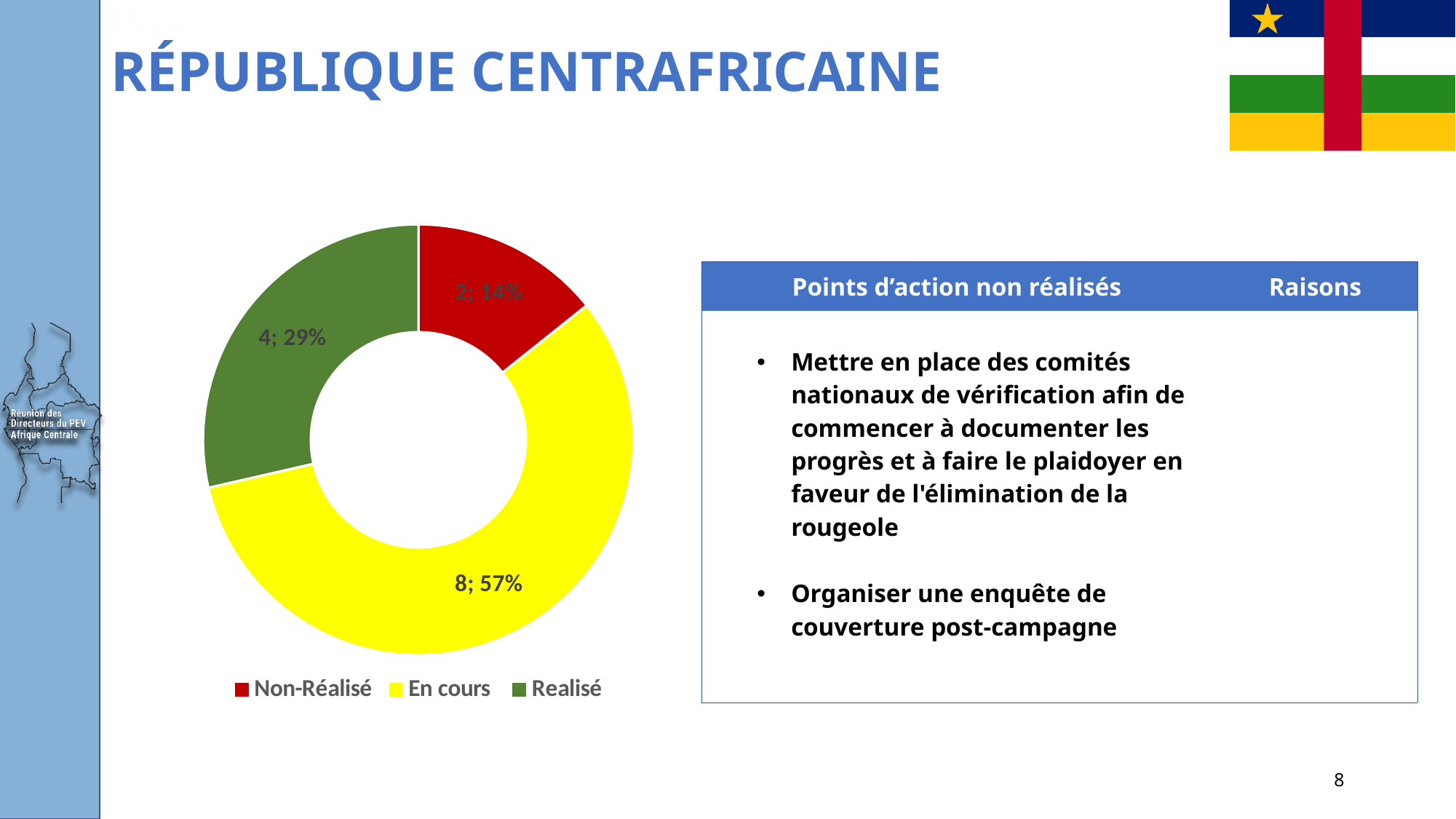
What is the count for the 'En cours' category? 8 How many categories does the chart show? 3 What is the count for the 'Realisé' category? 4 Which colour represents 'Non-Réalisé' in the legend? Red What is the count for the 'Non-Réalisé' category? 2 Which category has the smallest share of the chart? Non-Réalisé What share of the chart does 'Realisé' represent? 29% Which category has the largest share of the chart? En cours What share of the chart does 'En cours' represent? 57% What kind of chart is shown on the slide? Doughnut (pie) chart What is the difference in count between 'En cours' and 'Realisé'? 4 What share of the chart does 'Non-Réalisé' represent? 14%